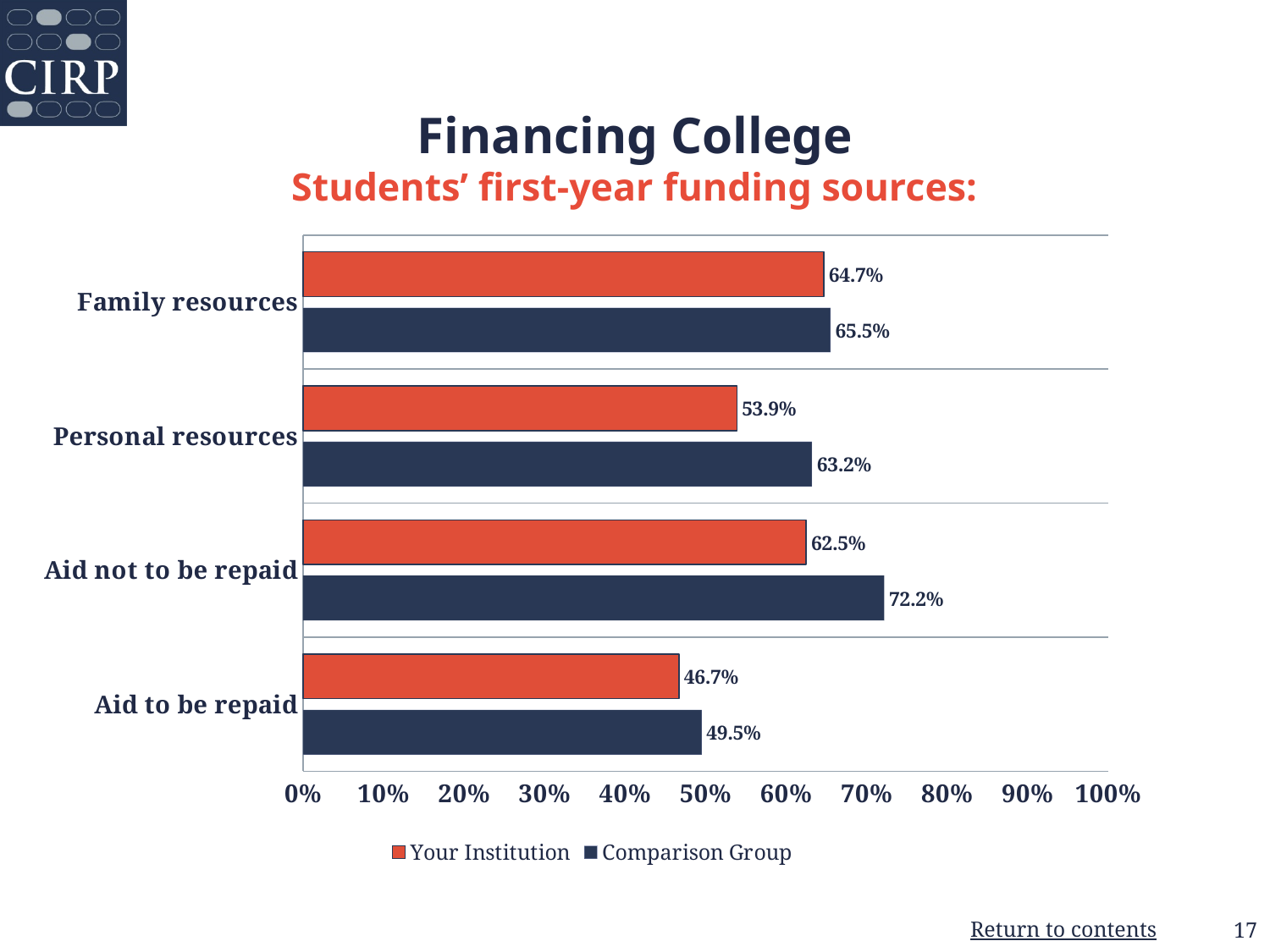
Which category has the highest value for the Comparison Group? Aid not to be repaid What is the difference between the Comparison Group and Your Institution values for Aid not to be repaid? 9.7% How many series does the legend list? 2 What is the difference between the Comparison Group and Your Institution values for Personal resources? 9.3% For Aid to be repaid, which is larger: Your Institution or Comparison Group? Comparison Group Which category has the lowest value for Your Institution? Aid to be repaid What kind of chart is shown on the slide? Bar chart What is the value for Comparison Group for Aid not to be repaid? 72.2% What is the value for Your Institution for Family resources? 64.7% What is the value for Comparison Group for Personal resources? 63.2% How many funding source categories are shown on the chart? 4 What is the value for Your Institution for Aid to be repaid? 46.7%